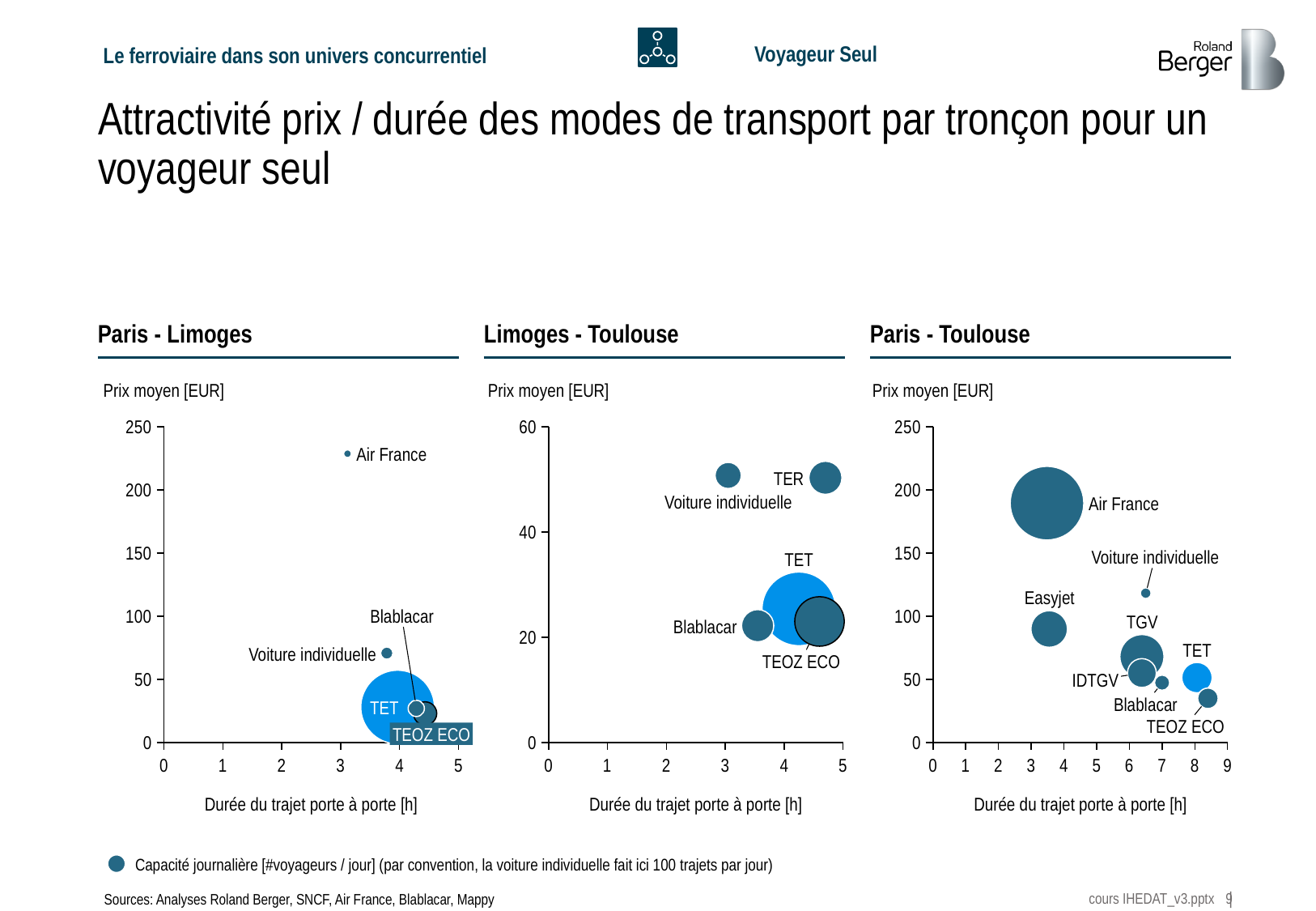
In the Paris - Toulouse chart, which transport mode has the lowest average price? TEOZ ECO In the Paris - Toulouse chart, which has the higher average price, Air France or Easyjet? Air France In the Paris - Toulouse chart, which transport mode has the highest average price? Air France In the Paris - Limoges chart, is the average price for Voiture individuelle greater or less than 100? less What is the label of the horizontal axis in the Paris - Toulouse chart? Durée du trajet porte à porte [h] How many transport modes are plotted in the Paris - Toulouse chart? 8 What kind of chart is used for the Paris - Limoges section? Bubble chart How many transport modes are plotted in the Paris - Limoges chart? 5 In the Paris - Limoges chart, is the average price for Air France greater or less than 200? greater In the Paris - Limoges chart, which transport mode has the highest average price? Air France In the Limoges - Toulouse chart, is the average price for Voiture individuelle greater or less than 40? greater In the Limoges - Toulouse chart, which has the higher average price, Voiture individuelle or Blablacar? Voiture individuelle